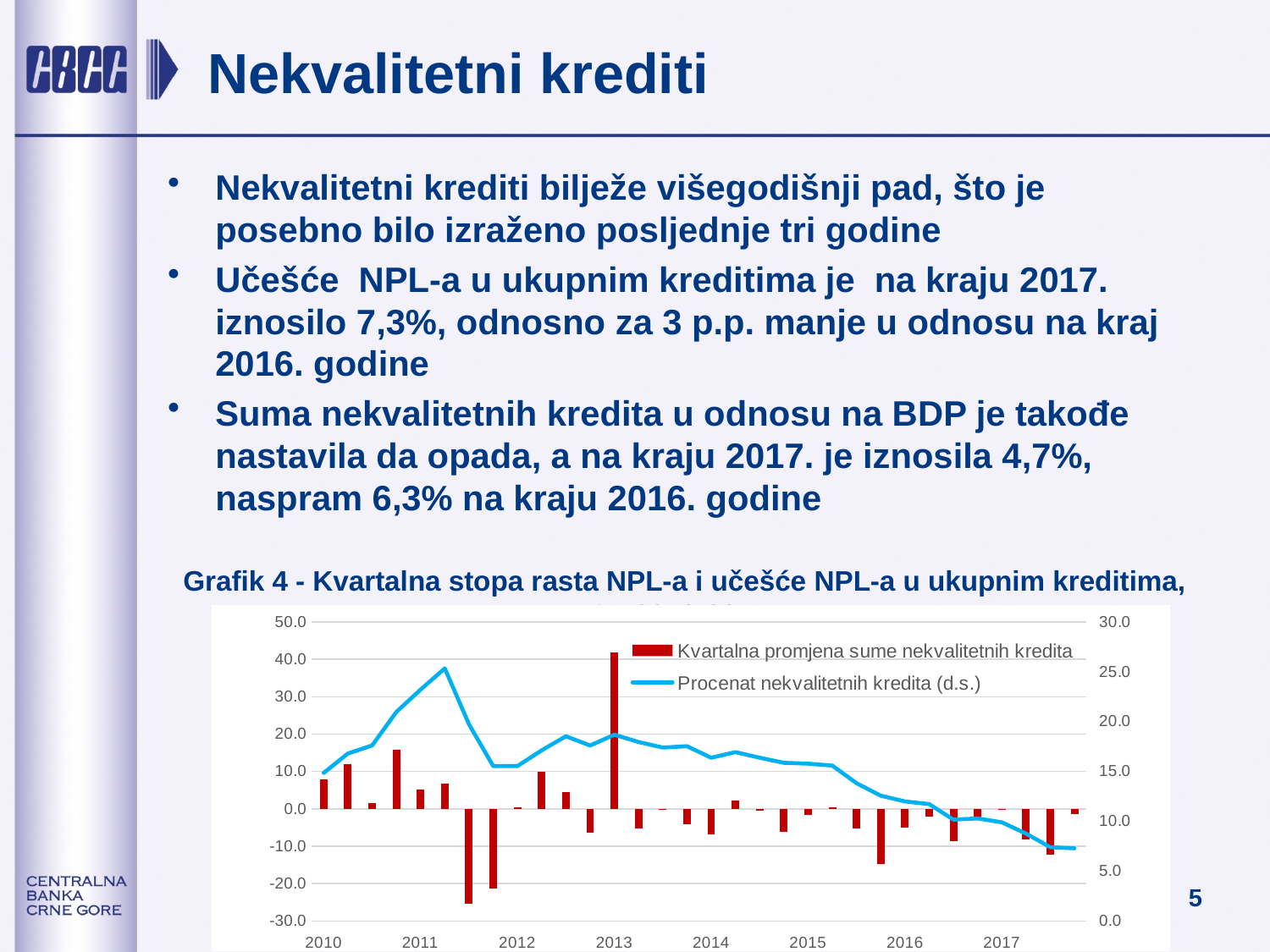
How many years are labelled on the x axis of Grafik 4? 8 How many series does the legend of Grafik 4 list? 2 In which year does the tallest positive bar in Grafik 4 occur? 2013 Is the value of the lowest bar in Grafik 4 greater or less than -20.0? less Which series in Grafik 4 is plotted on the right-hand (secondary) axis? Procenat nekvalitetnih kredita (d.s.) In which year does the lowest (most negative) bar in Grafik 4 occur? 2011 Is the peak of the 'Procenat nekvalitetnih kredita (d.s.)' line in Grafik 4 greater or less than 20.0 on the right axis? greater In which year does the line 'Procenat nekvalitetnih kredita (d.s.)' in Grafik 4 reach its peak? 2011 What colour are the bars for 'Kvartalna promjena sume nekvalitetnih kredita' in Grafik 4? Red Does the 'Procenat nekvalitetnih kredita (d.s.)' line in Grafik 4 rise or fall from 2013 to 2017? fall What kind of chart is Grafik 4? A combination bar and line chart Is the value of the tallest bar in Grafik 4 greater or less than 40.0? greater